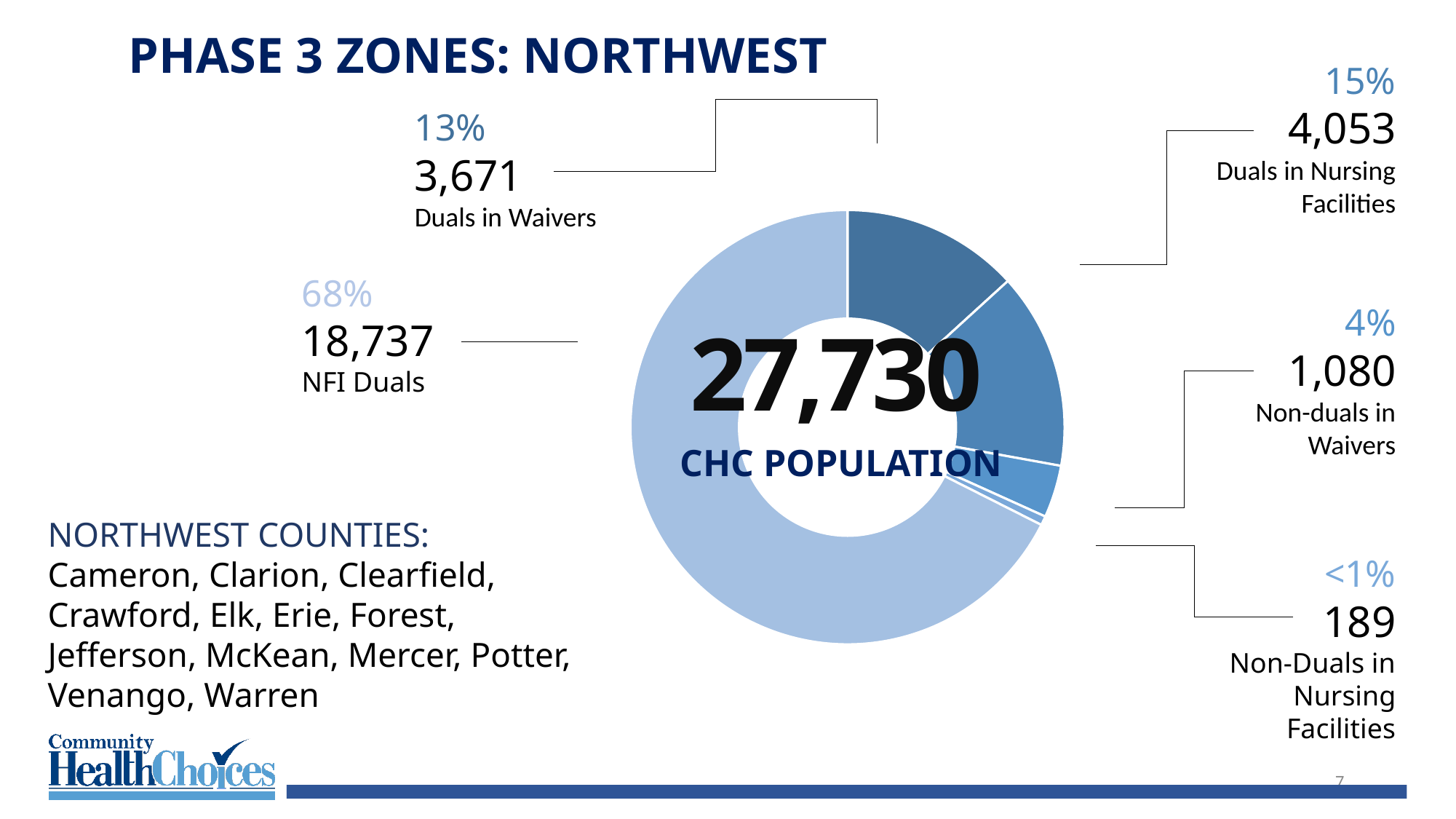
What kind of chart is shown on the slide? Doughnut chart Which category has the smallest share of the CHC population? Non-Duals in Nursing Facilities How many NFI Duals are shown? 18,737 What is the difference between the number of Duals in Nursing Facilities and Duals in Waivers? 382 What share of the CHC population are Non-duals in Waivers? 4% What percentage of the CHC population are Duals in Nursing Facilities? 15% How many Duals in Waivers are shown? 3,671 How many Non-Duals in Nursing Facilities are shown? 189 How many categories does the chart show? 5 Which category has the largest share of the CHC population? NFI Duals What is the total CHC population shown in the centre of the chart? 27,730 Which is larger: Duals in Nursing Facilities or Non-duals in Waivers? Duals in Nursing Facilities